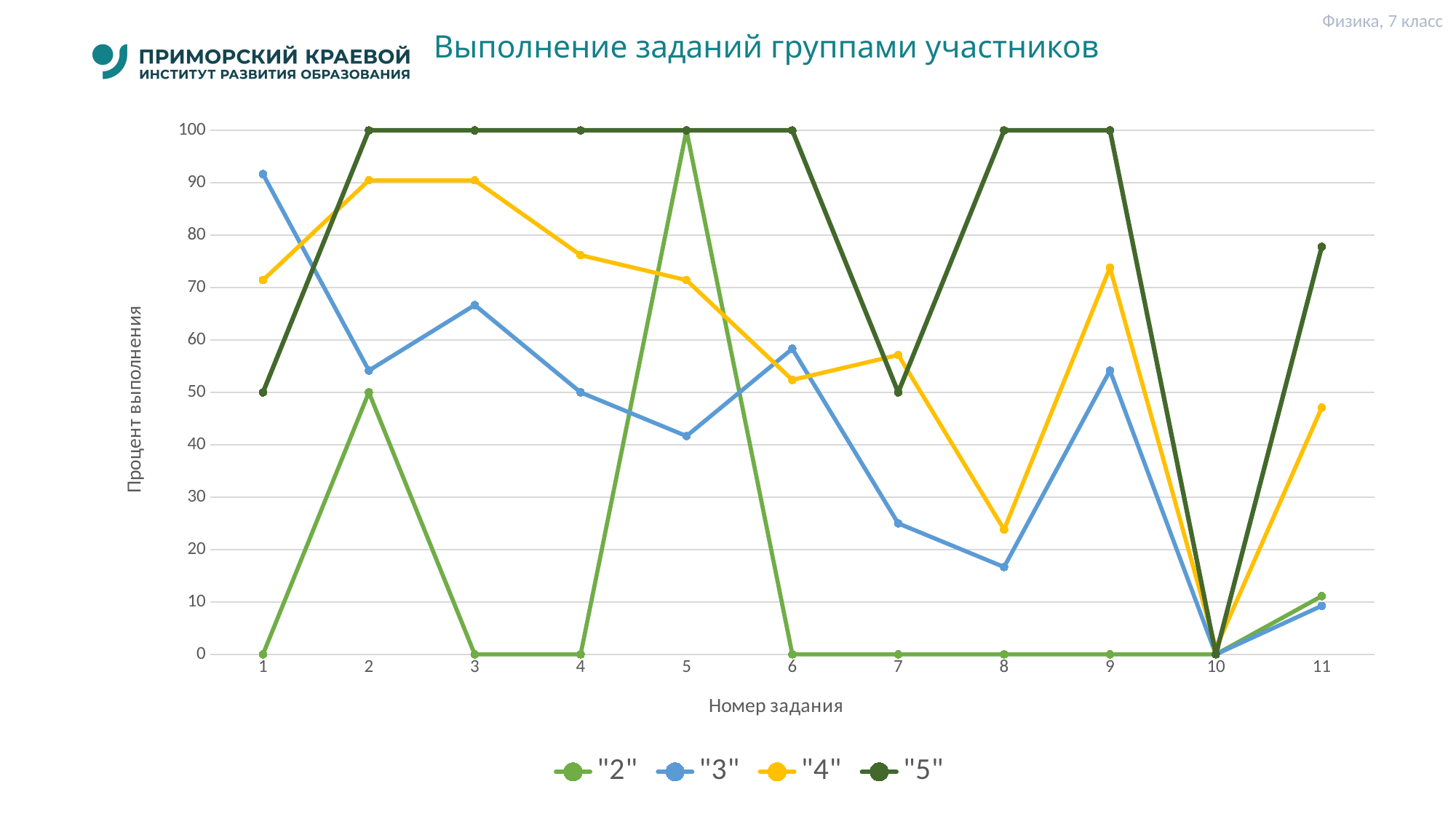
What is the value for series "5" at task 1? 50 What is the value for series "2" at task 2? 50 How many task numbers are shown along the x axis? 11 Is the value for series "3" at task 1 greater or less than 90? greater How many series does the legend list? 4 What is the title of the chart? Выполнение заданий группами участников Is the value for series "4" at task 8 greater or less than 30? less What kind of chart is shown on the slide? line chart Which series has the higher value at task 9, "3" or "4"? "4" What is the value for series "5" at task 7? 50 What is the value for series "2" at task 5? 100